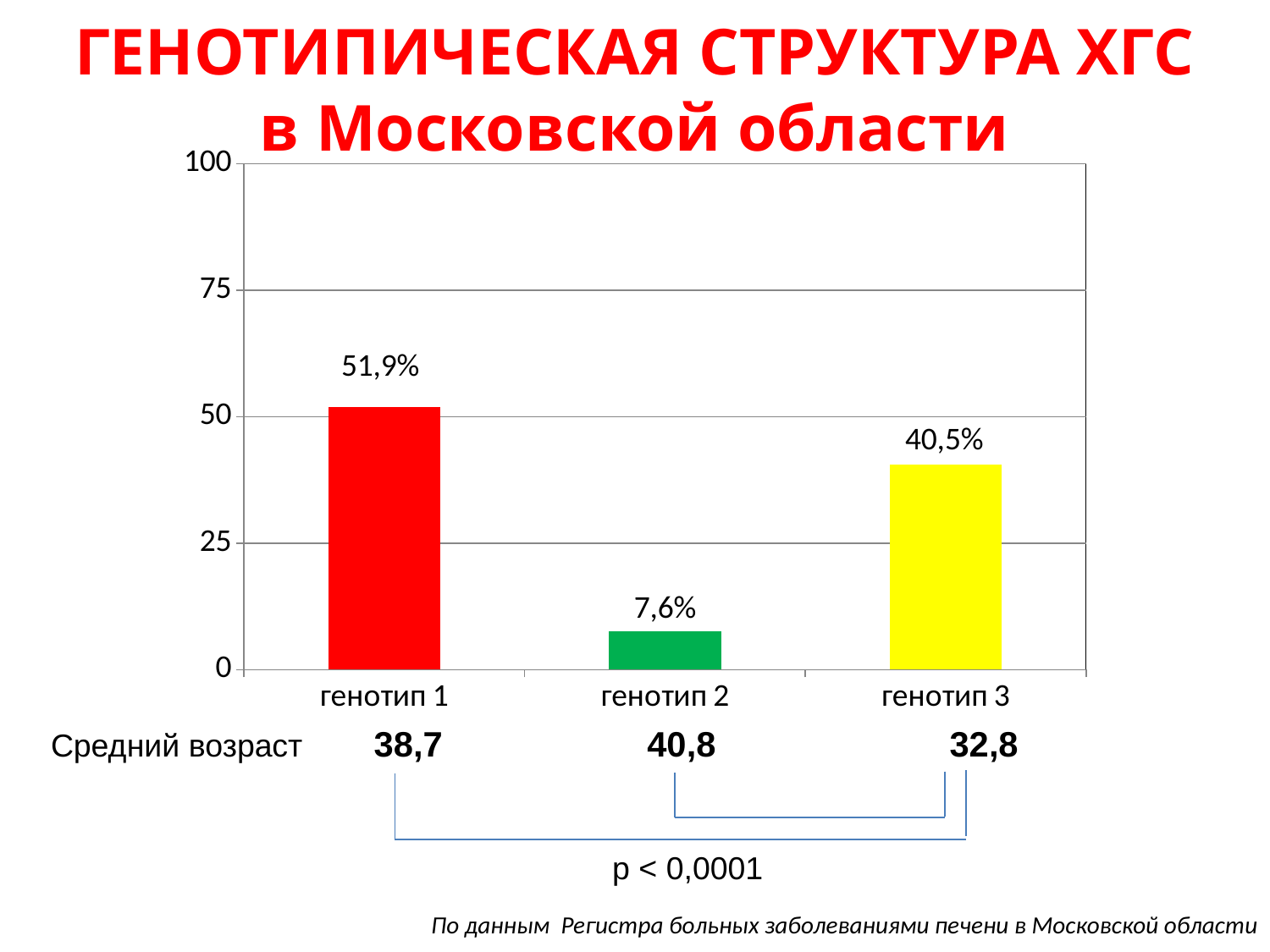
What is the value shown for генотип 1? 51,9% What kind of chart is shown on the slide? bar chart What colour is the bar for генотип 2? green Which genotype has the lowest share in the chart? генотип 2 Which genotype has the highest share in the chart? генотип 1 How many genotype categories are shown in the chart? 3 Which is larger, the value for генотип 2 or the value for генотип 3? генотип 3 What is the value shown for генотип 3? 40,5% What is the difference between the values for генотип 1 and генотип 3? 11,4% What is the title of the slide containing the chart? ГЕНОТИПИЧЕСКАЯ СТРУКТУРА ХГС в Московской области What is the value shown for генотип 2? 7,6% Is the value for генотип 1 greater or less than 50? greater